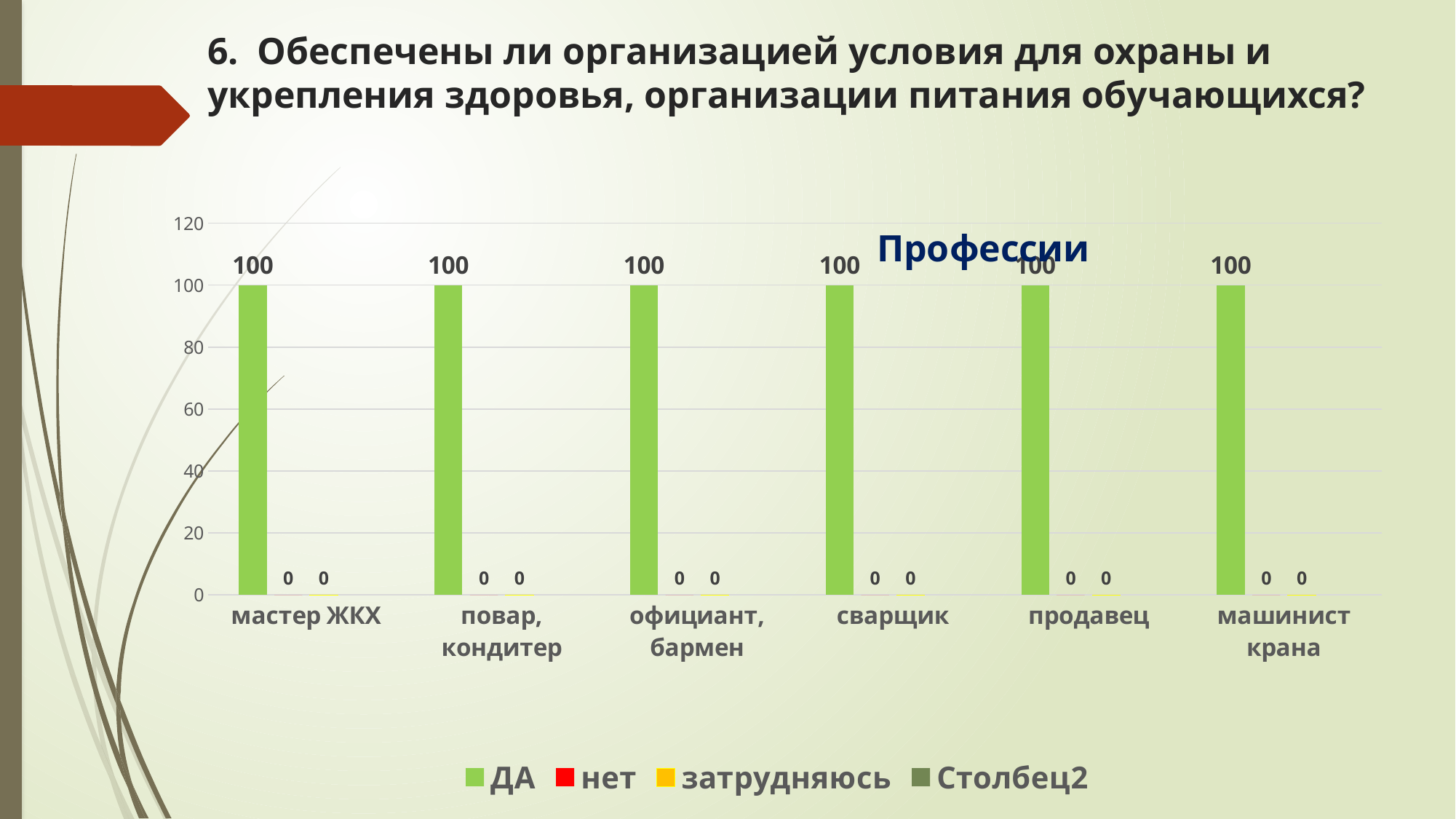
What is the value of затрудняюсь for машинист крана? 0 What is the title of the chart? Профессии How many categories are shown on the x axis? 6 What is the value of нет for повар, кондитер? 0 What is the value of ДА for мастер ЖКХ? 100 How many series does the legend list? 4 What is the value of ДА for сварщик? 100 What is the difference between the ДА value and the нет value for официант, бармен? 100 What colour are the ДА bars? green What is the value of ДА for продавец? 100 Which is larger for сварщик: the ДА value or the затрудняюсь value? ДА What kind of chart is shown on the slide? bar chart